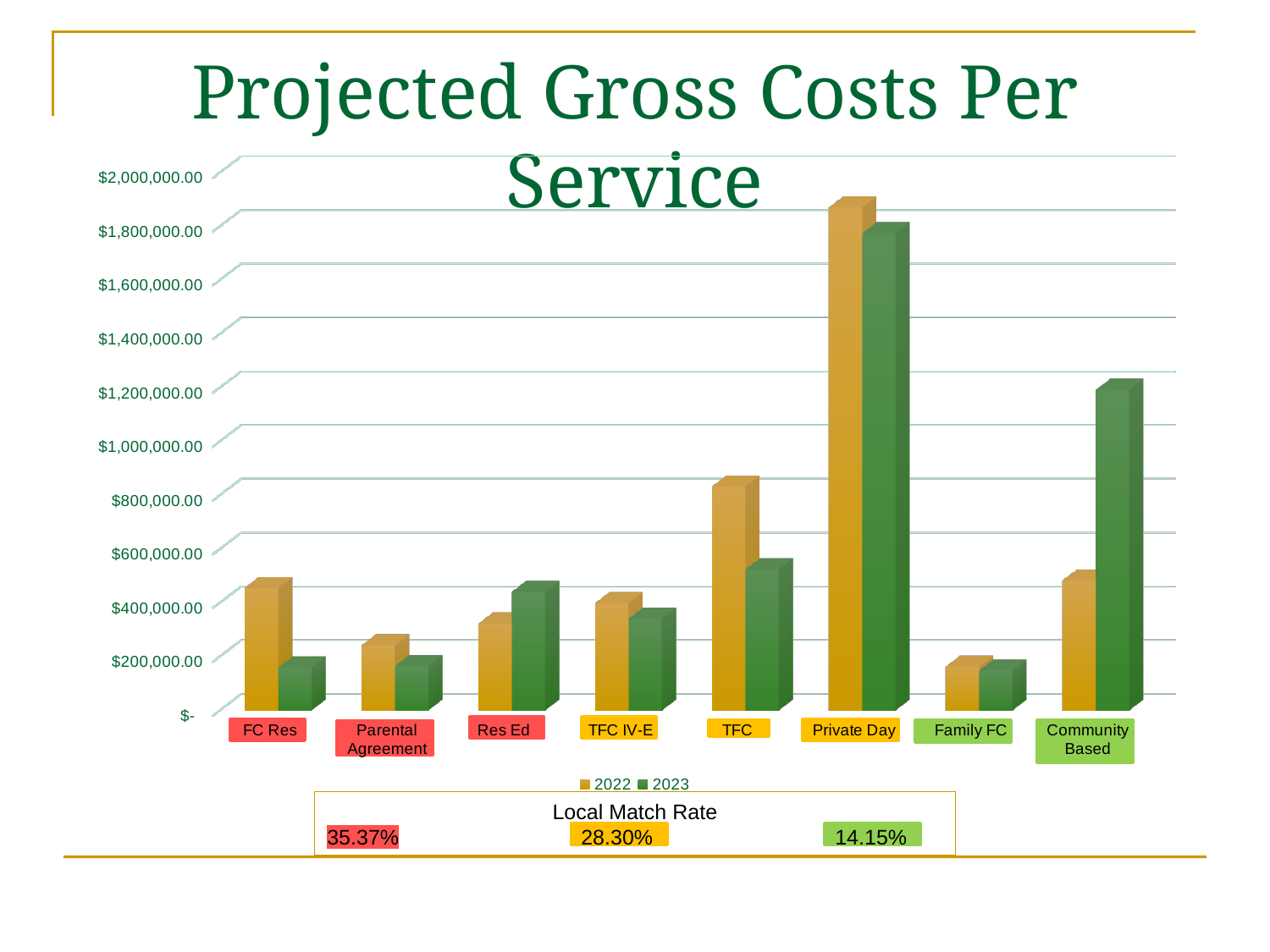
How many series does the legend list? 2 For Community Based, which year has the larger projected gross cost, 2022 or 2023? 2023 For TFC, which year has the larger projected gross cost, 2022 or 2023? 2022 Which service has the highest projected gross cost for 2023? Private Day Is the 2023 value for Community Based greater or less than $1,000,000.00? greater Which service has the highest projected gross cost for 2022? Private Day What is the title of the chart? Projected Gross Costs Per Service Is the 2022 value for Private Day greater or less than $1,600,000.00? greater Which service has the lowest projected gross cost for 2022? Family FC Is the 2022 value for Parental Agreement greater or less than $400,000.00? less What kind of chart is shown on the slide? bar chart How many service categories are shown on the x axis? 8